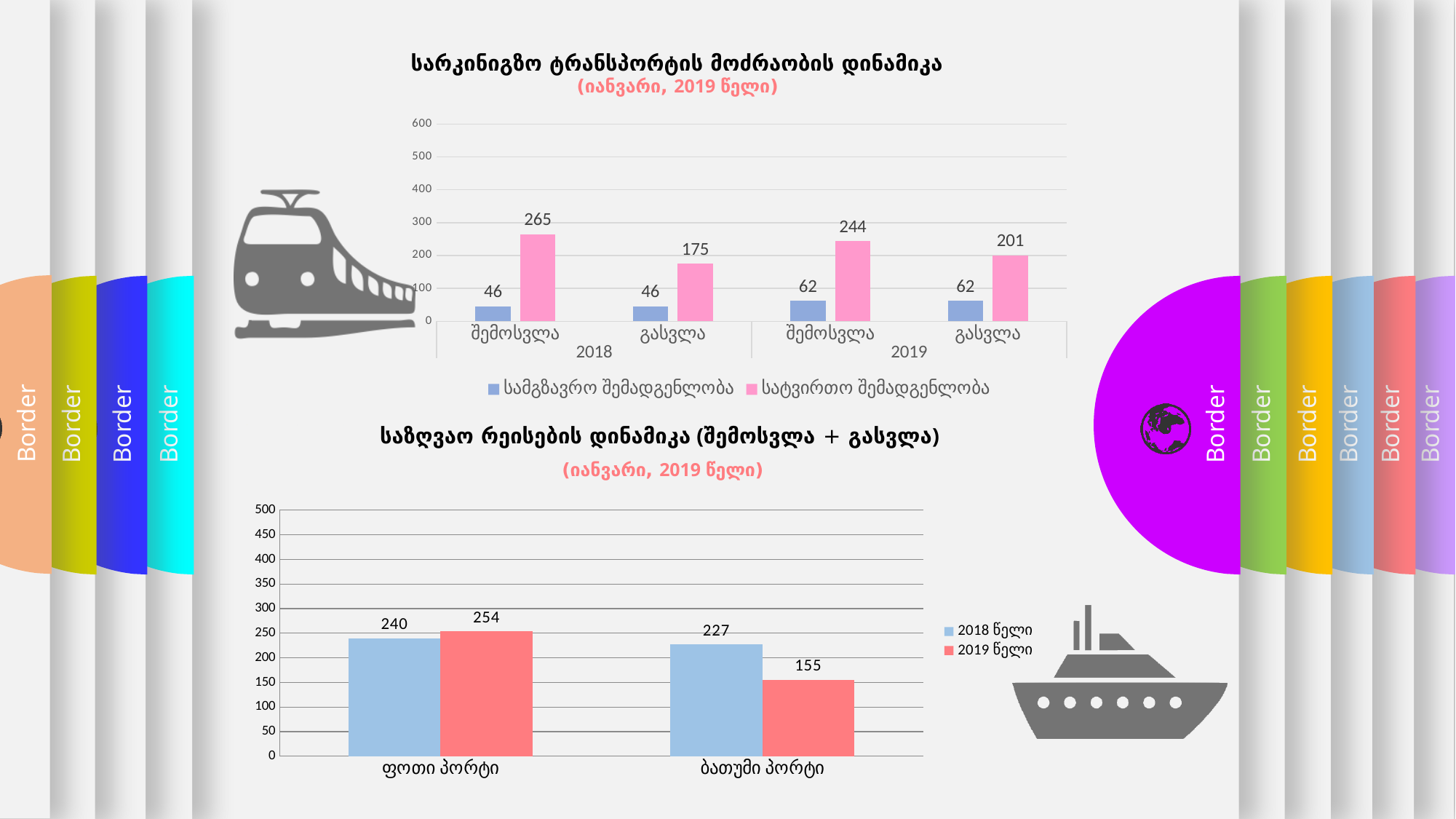
In the bottom chart, how many port categories are shown on the x axis? 2 In the top chart, what is the value of სამგზავრო შემადგენლობა for გასვლა in 2019? 62 In the bottom chart, which is larger for ბათუმი პორტი: 2018 წელი or 2019 წელი? 2018 წელი In the bottom chart (საზღვაო რეისების დინამიკა), what is the value for ბათუმი პორტი in 2019 წელი? 155 In the top chart, what is the difference between სატვირთო შემადგენლობა and სამგზავრო შემადგენლობა for შემოსვლა in 2019? 182 In the bottom chart, what is the value for ფოთი პორტი in 2018 წელი? 240 In the top chart (სარკინიგზო ტრანსპორტის მოძრაობის დინამიკა), what is the value of სატვირთო შემადგენლობა for შემოსვლა in 2018? 265 In the top chart, which category has the highest value for სატვირთო შემადგენლობა? შემოსვლა 2018 In the bottom chart, what is the difference between the 2018 წელი and 2019 წელი values for ბათუმი პორტი? 72 What kind of chart is the bottom chart? Bar chart In the top chart, how many series does the legend list? 2 In the top chart, which category has the lowest value for სატვირთო შემადგენლობა? გასვლა 2018